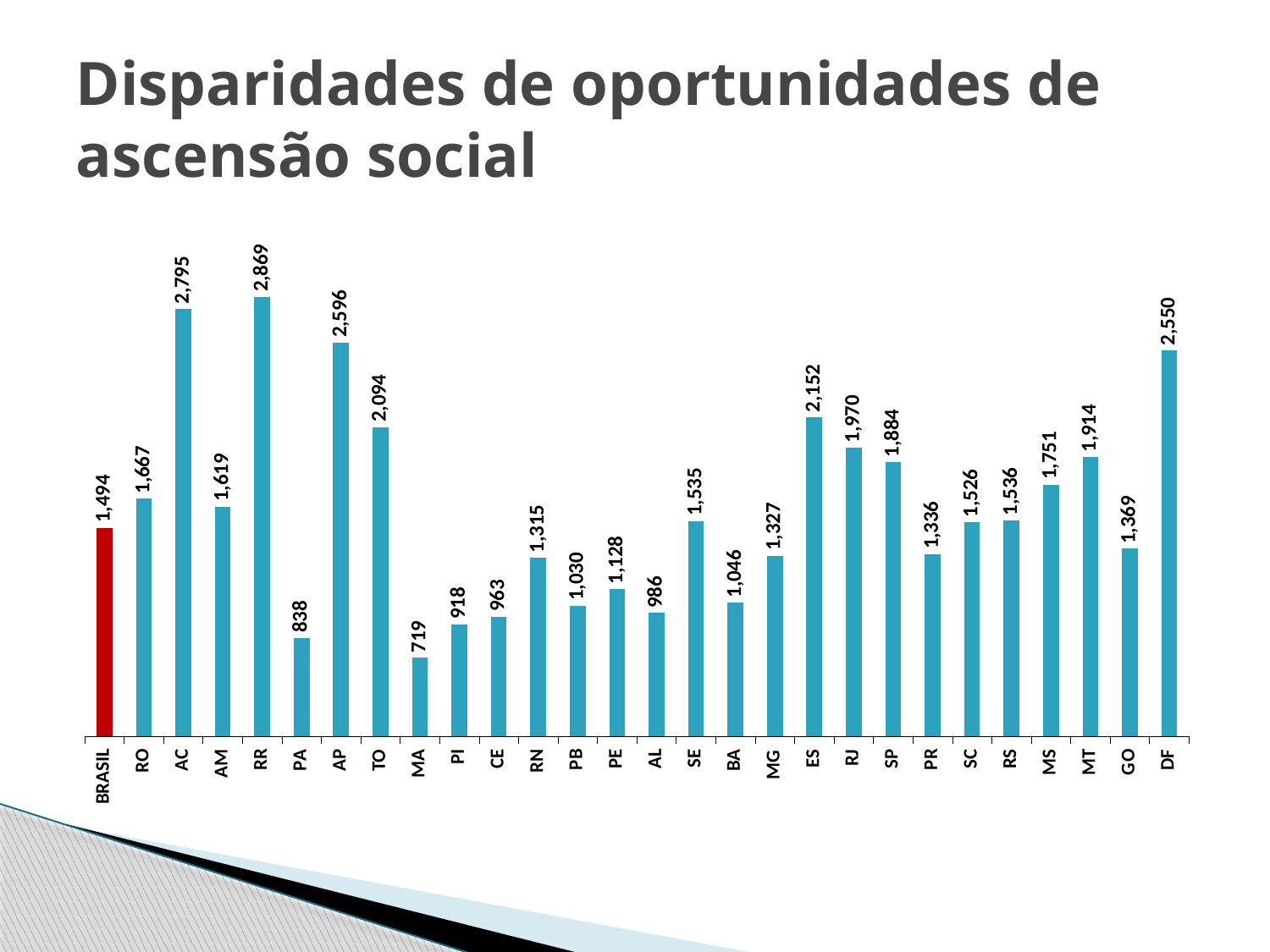
What is the value shown for MA? 719 What is the value shown for DF? 2,550 What is the value shown for BRASIL? 1,494 Which bar is coloured red instead of blue? BRASIL What kind of chart is shown on the slide? Bar chart What is the value shown for SP? 1,884 How many categories are shown on the x axis? 28 Which category has the lowest value? MA What is the difference between the values for RR and AC? 74 What is the difference between the values for DF and BRASIL? 1,056 Which category has the highest value? RR Which has a larger value, RJ or SP? RJ